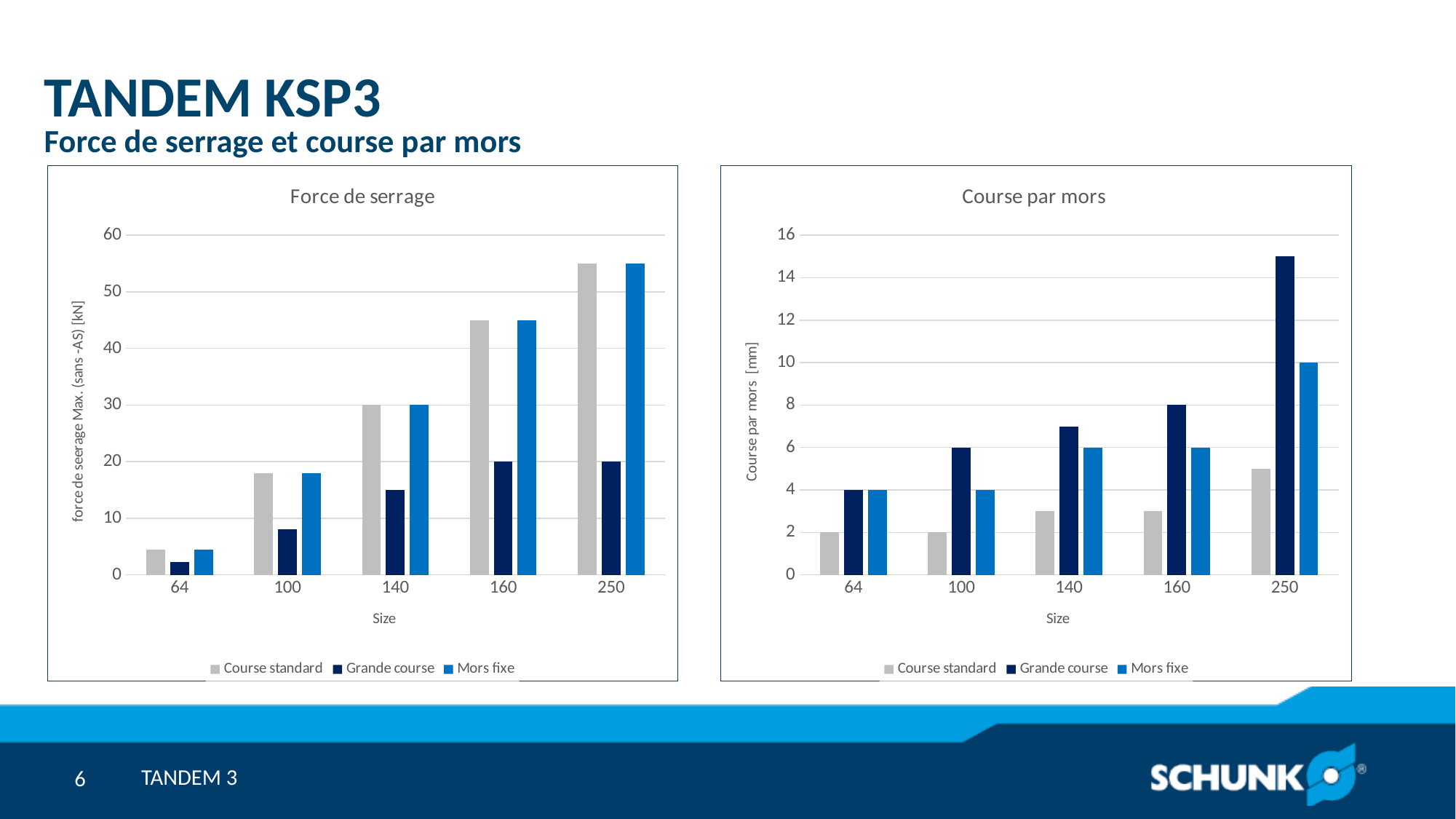
In the 'Force de serrage' chart, what is the value for Course standard at size 140? 30 In the 'Force de serrage' chart, which size has the lowest Grande course value? 64 In the 'Force de serrage' chart, how many series does the legend list? 3 In the 'Force de serrage' chart, does the Course standard value rise or fall as size increases from 64 to 250? rise In the 'Course par mors' chart, is the value for Grande course at size 250 greater or less than 14? greater In the 'Course par mors' chart, what is the value for Mors fixe at size 250? 10 In the 'Force de serrage' chart, is the value for Mors fixe at size 250 greater or less than 50? greater In the 'Force de serrage' chart, what is the value for Grande course at size 160? 20 What type of chart is 'Course par mors'? bar chart In the 'Course par mors' chart, what is the value for Grande course at size 160? 8 In the 'Course par mors' chart, which size has the highest Grande course value? 250 In the 'Course par mors' chart, which is larger at size 140: Grande course or Mors fixe? Grande course